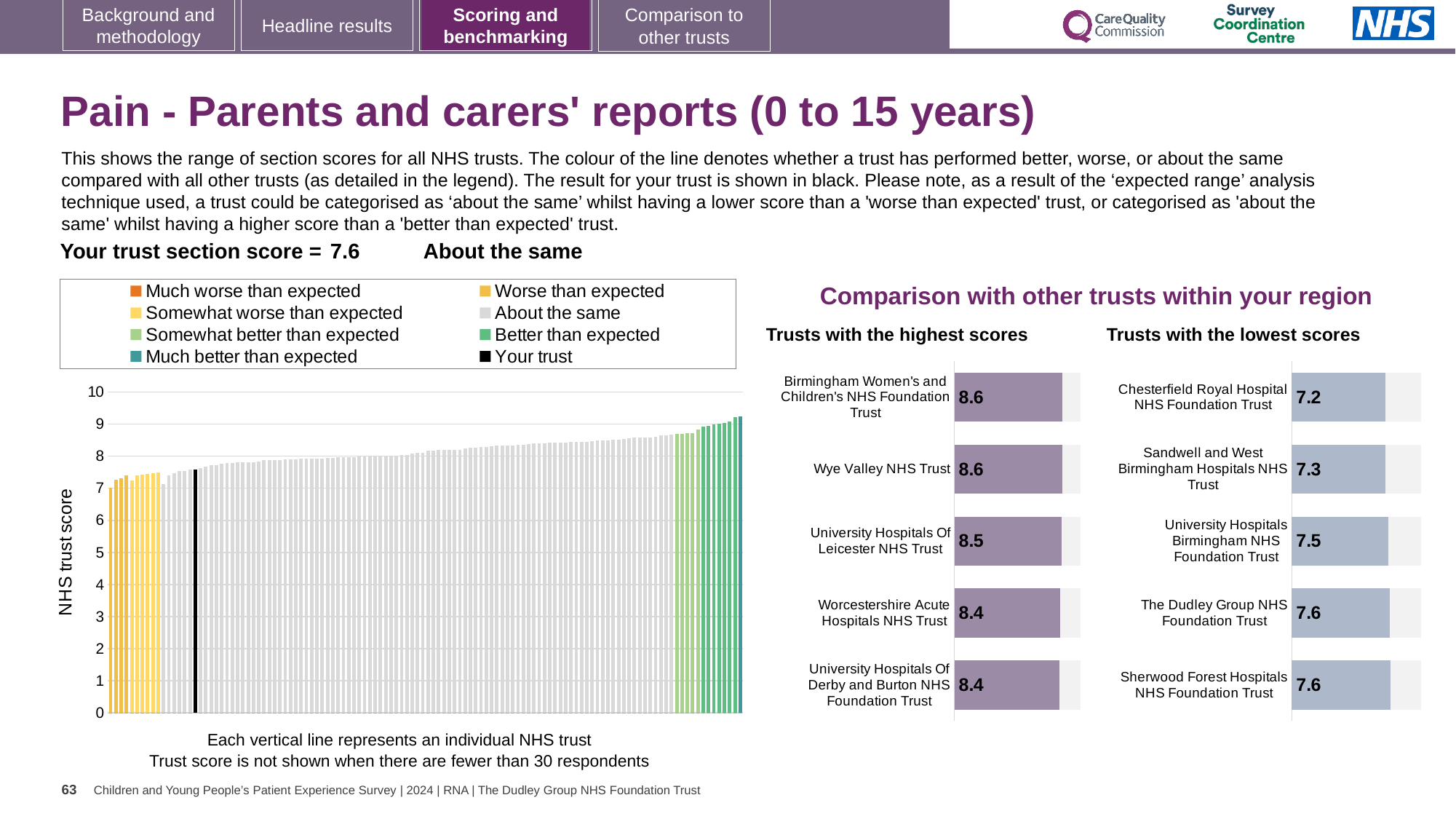
How many entries does the legend above the large chart on the left list? 8 In the large chart on the left, is the value for the black 'Your trust' bar greater or less than 5? greater What kind of chart is the large chart on the left showing NHS trust scores? Bar chart In the 'Trusts with the highest scores' chart, which has the higher score: University Hospitals Of Leicester NHS Trust or Worcestershire Acute Hospitals NHS Trust? University Hospitals Of Leicester NHS Trust In the 'Trusts with the lowest scores' chart, which trust has the lowest score? Chesterfield Royal Hospital NHS Foundation Trust In the 'Trusts with the highest scores' chart, what is the score for University Hospitals Of Leicester NHS Trust? 8.5 How many trusts are shown in the 'Trusts with the lowest scores' chart? 5 In the 'Trusts with the lowest scores' chart, what is the score for Chesterfield Royal Hospital NHS Foundation Trust? 7.2 In the 'Trusts with the lowest scores' chart, what is the difference between the scores of The Dudley Group NHS Foundation Trust and Chesterfield Royal Hospital NHS Foundation Trust? 0.4 In the 'Trusts with the highest scores' chart, what is the score for Wye Valley NHS Trust? 8.6 In the 'Trusts with the lowest scores' chart, what is the difference between the scores of Sandwell and West Birmingham Hospitals NHS Trust and Chesterfield Royal Hospital NHS Foundation Trust? 0.1 In the large chart on the left, do the trust scores rise or fall from left to right? Rise